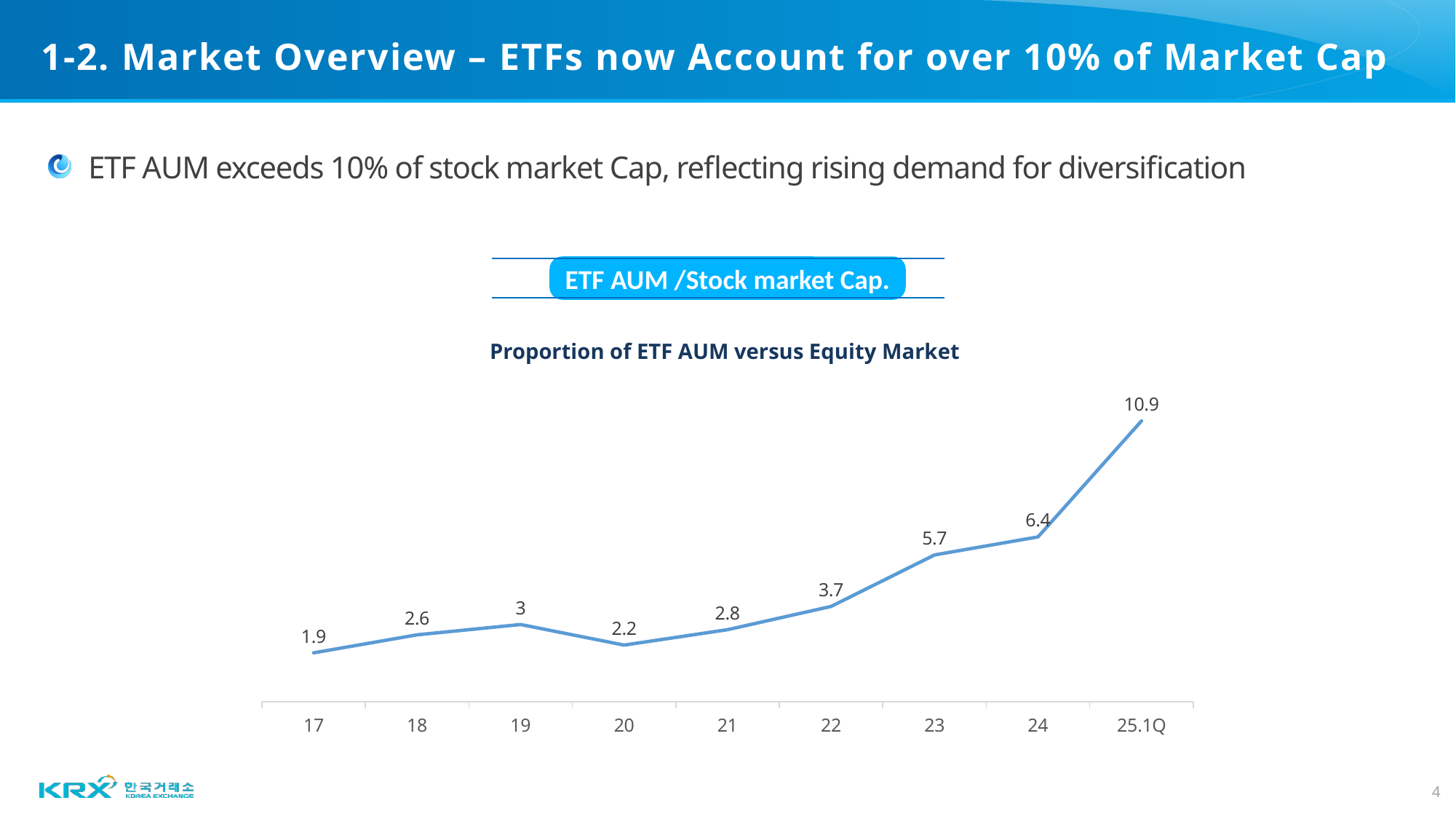
What kind of chart is shown on the slide? line chart What is the value for 23 in the Proportion of ETF AUM versus Equity Market chart? 5.7 Which x-axis category has the lowest value in the chart? 17 What is the value for 20 in the Proportion of ETF AUM versus Equity Market chart? 2.2 Do the values generally rise or fall from 20 to 25.1Q? rise What is the value for 25.1Q in the Proportion of ETF AUM versus Equity Market chart? 10.9 How many data points are plotted on the line? 9 What is the difference between the values for 19 and 20? 0.8 Which is larger, the value for 19 or the value for 21? 19 What is the title of the chart? Proportion of ETF AUM versus Equity Market Which x-axis category has the highest value in the chart? 25.1Q What is the difference between the values for 25.1Q and 24? 4.5